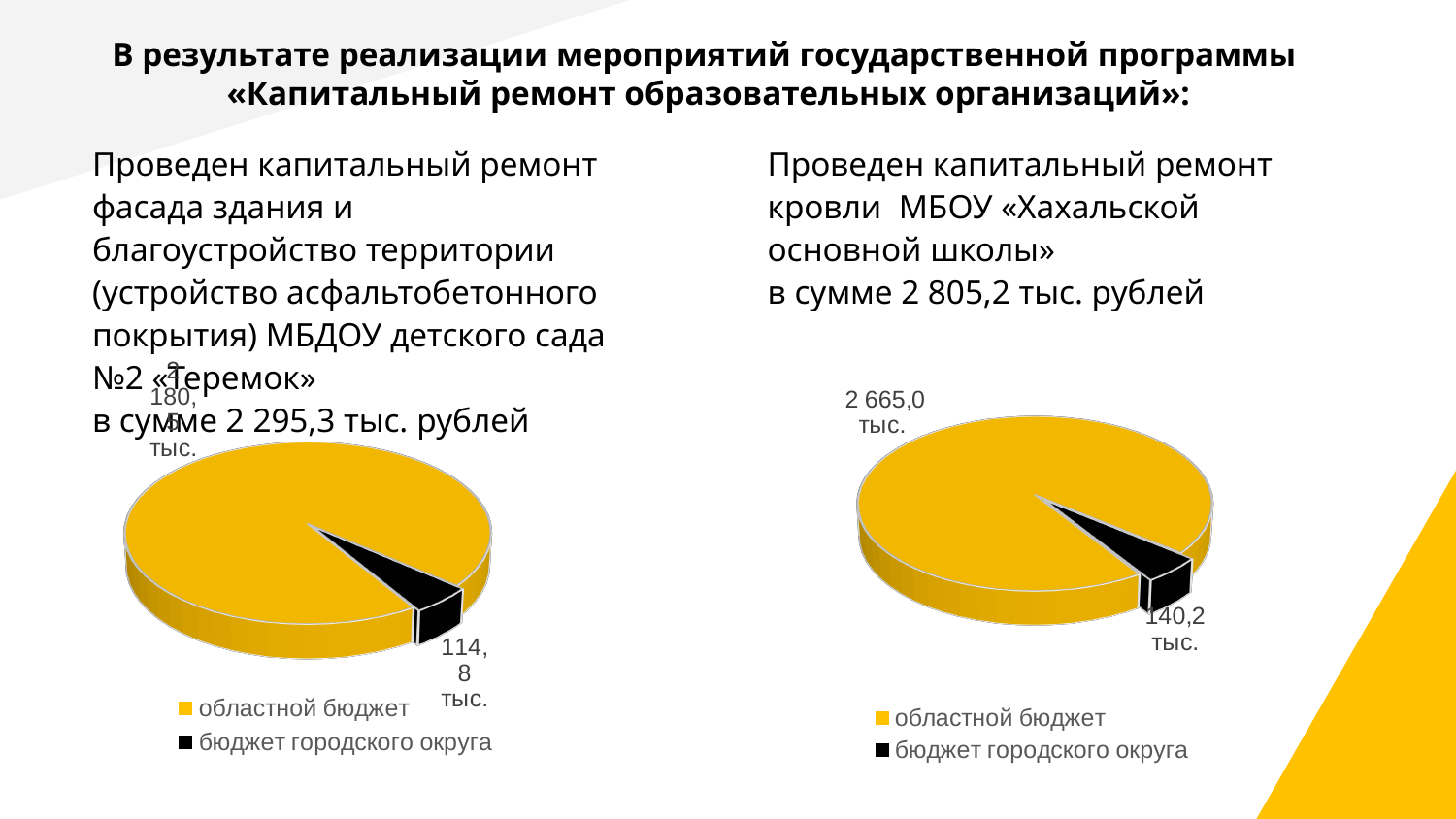
In the right pie chart, what is the difference between областной бюджет and бюджет городского округа? 2 524,8 тыс. How many entries does the legend of the right chart list? 2 In the left pie chart, what is the value for бюджет городского округа? 114,8 тыс. In the left pie chart, which category has the smallest slice? бюджет городского округа In the right pie chart, what is the value for областной бюджет? 2 665,0 тыс. How many slices does the right pie chart have? 2 Which chart shows a larger value for бюджет городского округа, the left chart or the right chart? the right chart In the right pie chart, what is the value for бюджет городского округа? 140,2 тыс. In the right pie chart, which category has the largest slice? областной бюджет In the right pie chart, which is larger: областной бюджет or бюджет городского округа? областной бюджет In the left pie chart, what colour represents областной бюджет? yellow What type of chart is used on the left side of the slide? pie chart